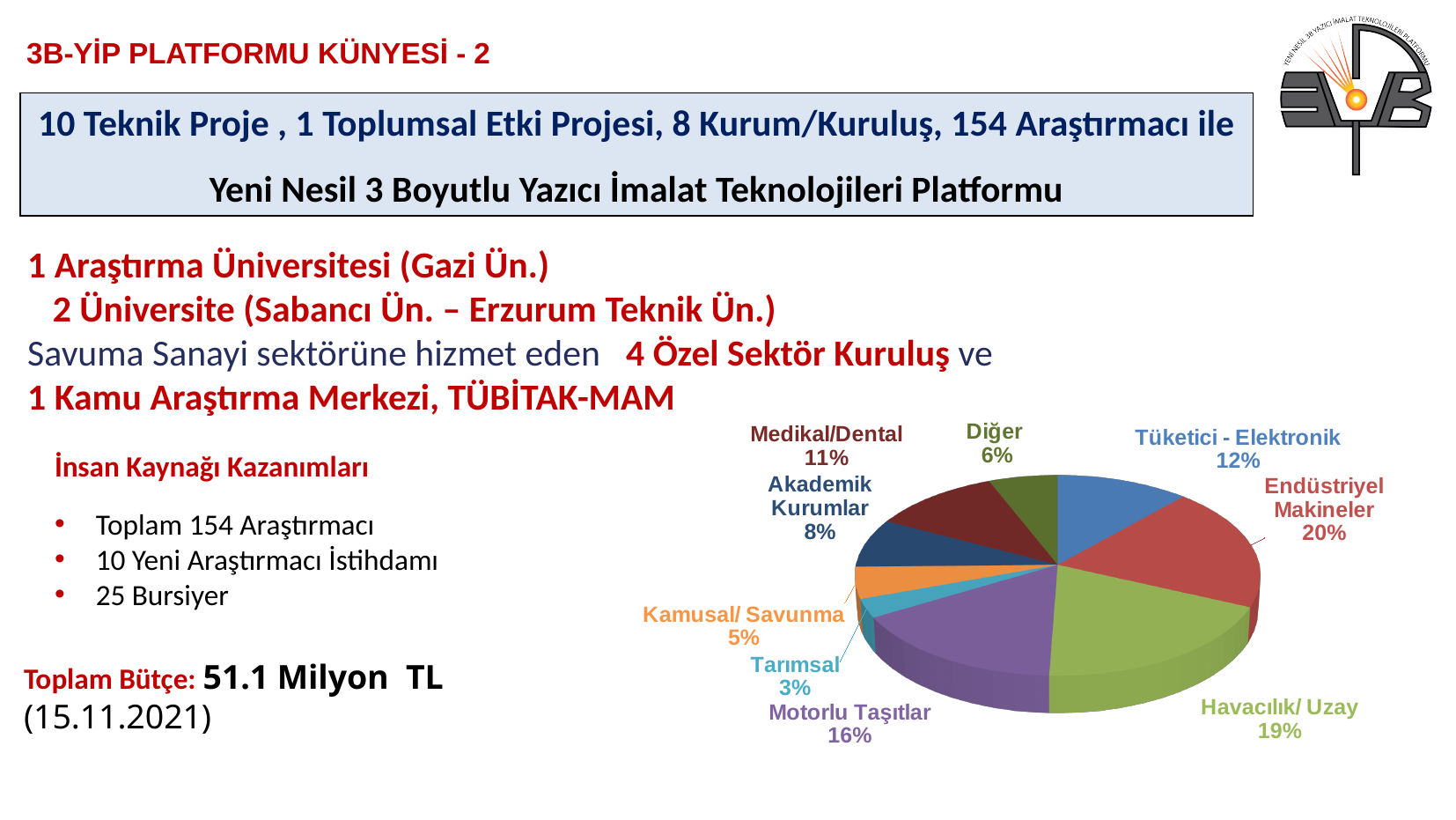
What is the value shown for Diğer? 6% How many slices does the pie chart have? 9 What is the value shown for Motorlu Taşıtlar? 16% What is the combined share of Tarımsal and Kamusal/ Savunma? 8% What is the value shown for Havacılık/ Uzay? 19% What is the difference in percentage points between Tüketici - Elektronik and Kamusal/ Savunma? 7 What share of the pie does Endüstriyel Makineler have? 20% What colour is the Havacılık/ Uzay slice? Green Which category has the largest slice of the pie? Endüstriyel Makineler Which is larger, Medikal/Dental or Akademik Kurumlar? Medikal/Dental What kind of chart is shown on the slide? Pie chart Which category has the smallest slice of the pie? Tarımsal